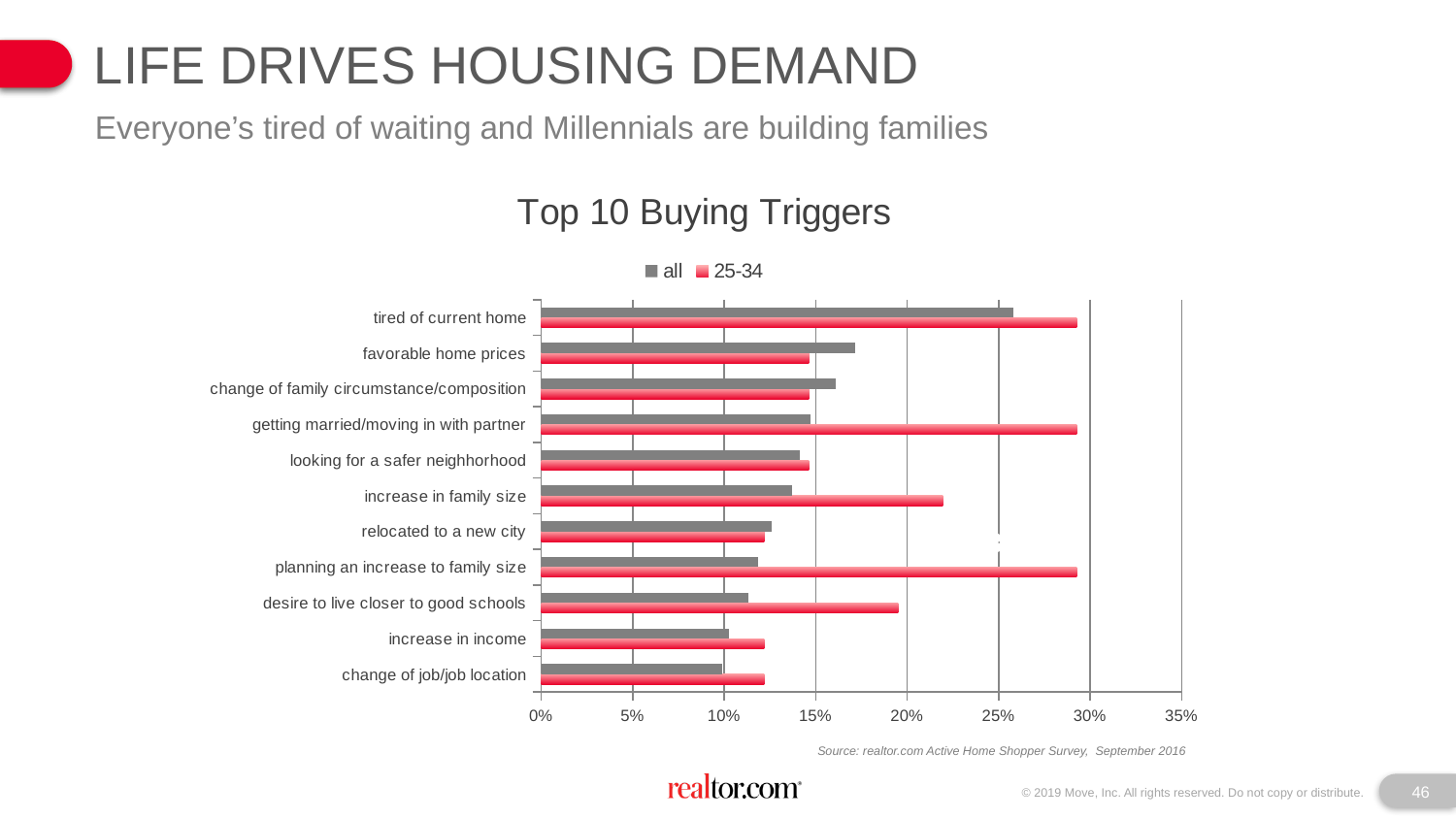
What kind of chart is shown on the slide? bar chart Which series is shown in red in the legend? 25-34 Which category has the highest value for the 'all' series? tired of current home For 'favorable home prices', which series has the larger value, 'all' or '25-34'? all For 'getting married/moving in with partner', which series has the larger value, 'all' or '25-34'? 25-34 Is the '25-34' value for 'desire to live closer to good schools' greater or less than 20%? less What is the title of the chart? Top 10 Buying Triggers How many buying-trigger categories are plotted on the chart? 11 How many series does the legend list? 2 Is the '25-34' value for 'getting married/moving in with partner' greater or less than 25%? greater Is the 'all' value for 'tired of current home' greater or less than 25%? greater